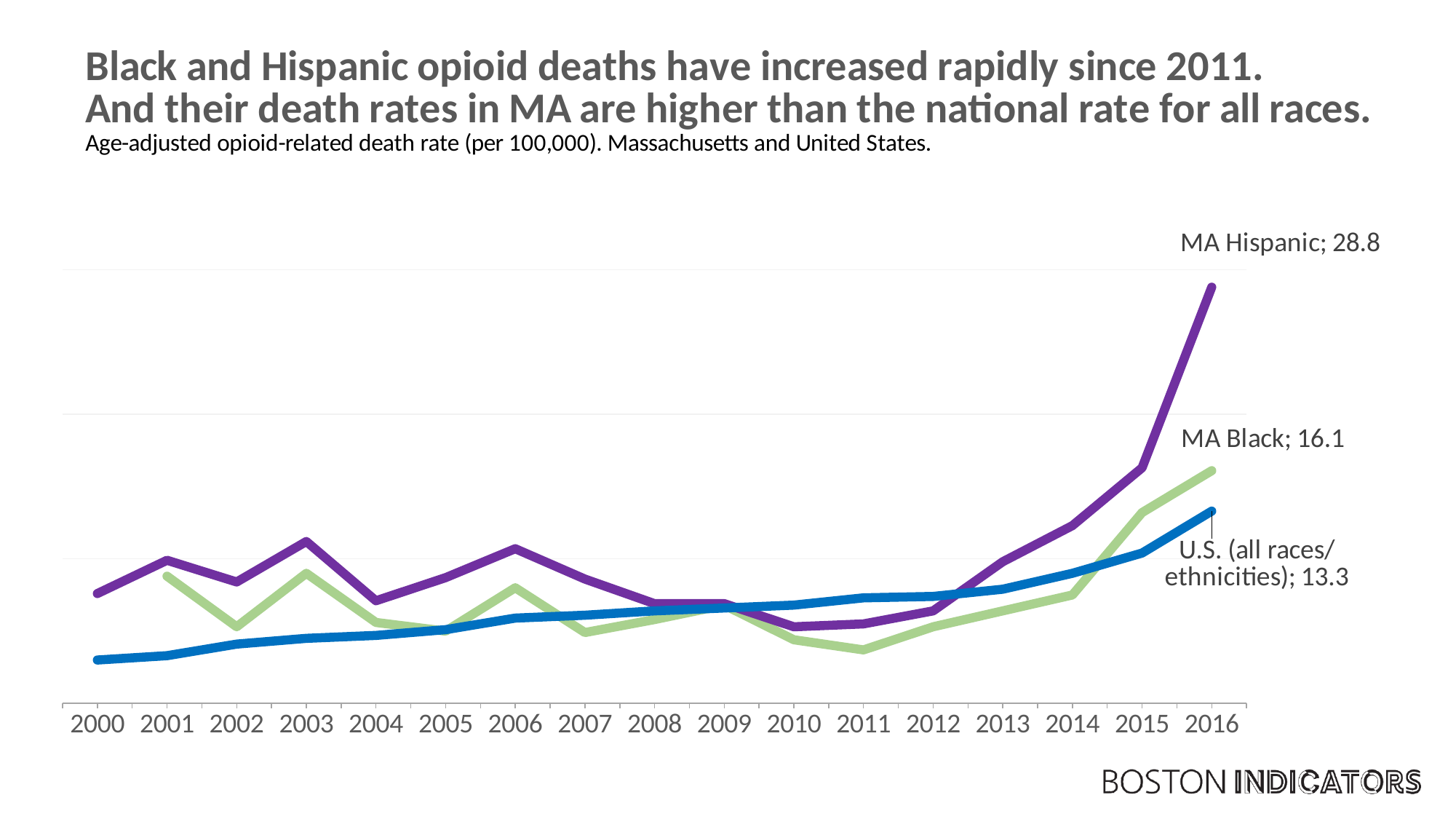
What is the difference between the 2016 values for MA Black and U.S. (all races/ethnicities)? 2.8 What type of chart is shown on the slide? line chart Which series has the lowest value in 2016? U.S. (all races/ethnicities) In 2016, which is larger: the MA Black value or the U.S. (all races/ethnicities) value? MA Black What is the difference between the 2016 values for MA Hispanic and MA Black? 12.7 How many series are plotted on the chart? 3 Which series has the highest value in 2016? MA Hispanic What is the 2016 value for MA Black? 16.1 Does the MA Hispanic line rise or fall from 2011 to 2016? rise How many years are shown on the x axis? 17 What is the 2016 value for MA Hispanic? 28.8 What is the 2016 value for U.S. (all races/ethnicities)? 13.3